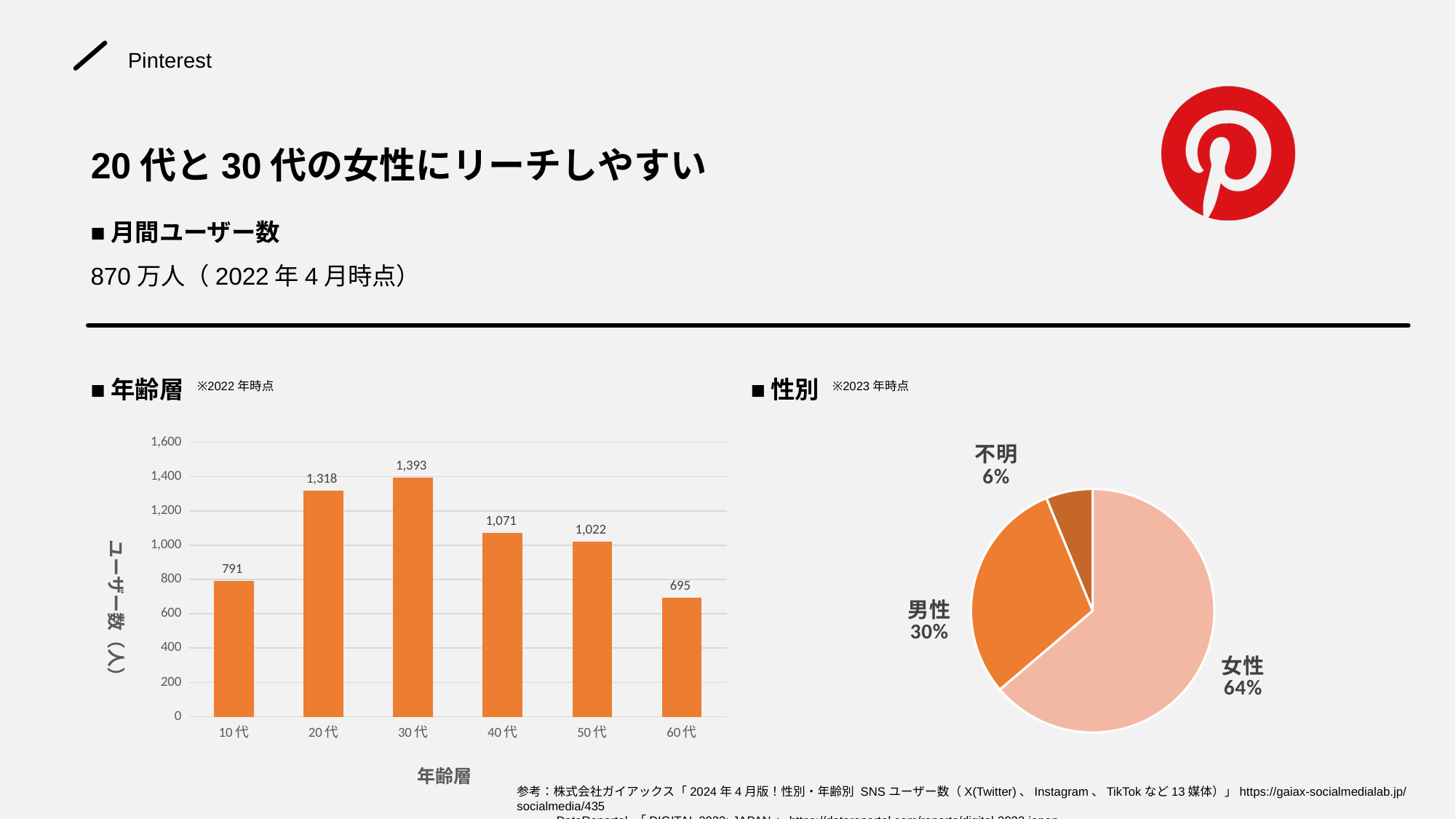
In the 年齢層 bar chart, what is the difference between the values for 30代 and 20代? 75 In the 年齢層 bar chart, is the value for 60代 greater or less than 800? less In the 年齢層 bar chart, which age group has the highest value? 30代 In the 年齢層 bar chart, what is the value for 30代? 1,393 In the 性別 pie chart, what share is 不明? 6% What kind of chart is the 性別 chart? pie chart In the 年齢層 bar chart, which age group has the lowest value? 60代 In the 年齢層 bar chart, what is the value for 10代? 791 In the 性別 pie chart, what share is 女性? 64% What kind of chart is the 年齢層 chart? bar chart How many age groups are shown in the 年齢層 bar chart? 6 In the 年齢層 bar chart, which is larger, the value for 40代 or 50代? 40代